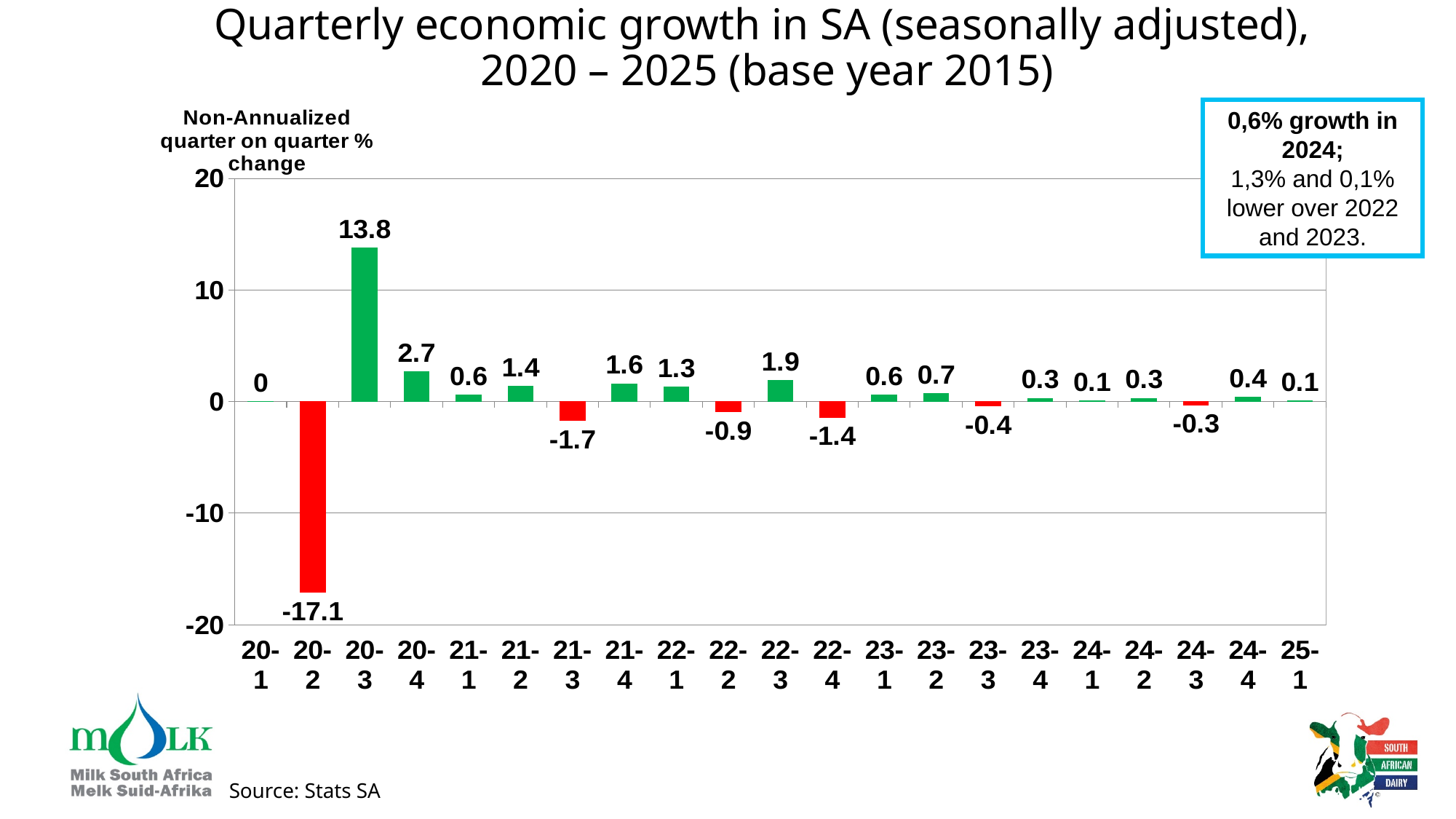
What is the title of the chart? Quarterly economic growth in SA (seasonally adjusted), 2020 – 2025 (base year 2015) What is the difference between the values for 20-3 and 20-4? 11.1 Which is larger, the value for 21-4 or the value for 22-1? 21-4 What is the value for 22-3? 1.9 How many quarters are shown on the x axis? 21 Is the value for 20-3 greater or less than 10? greater Which quarter has the highest value? 20-3 Which quarter has the lowest value? 20-2 What colour are the bars with negative values? red What is the value for 20-2? -17.1 What kind of chart is shown on the slide? bar chart What is the value for 24-4? 0.4